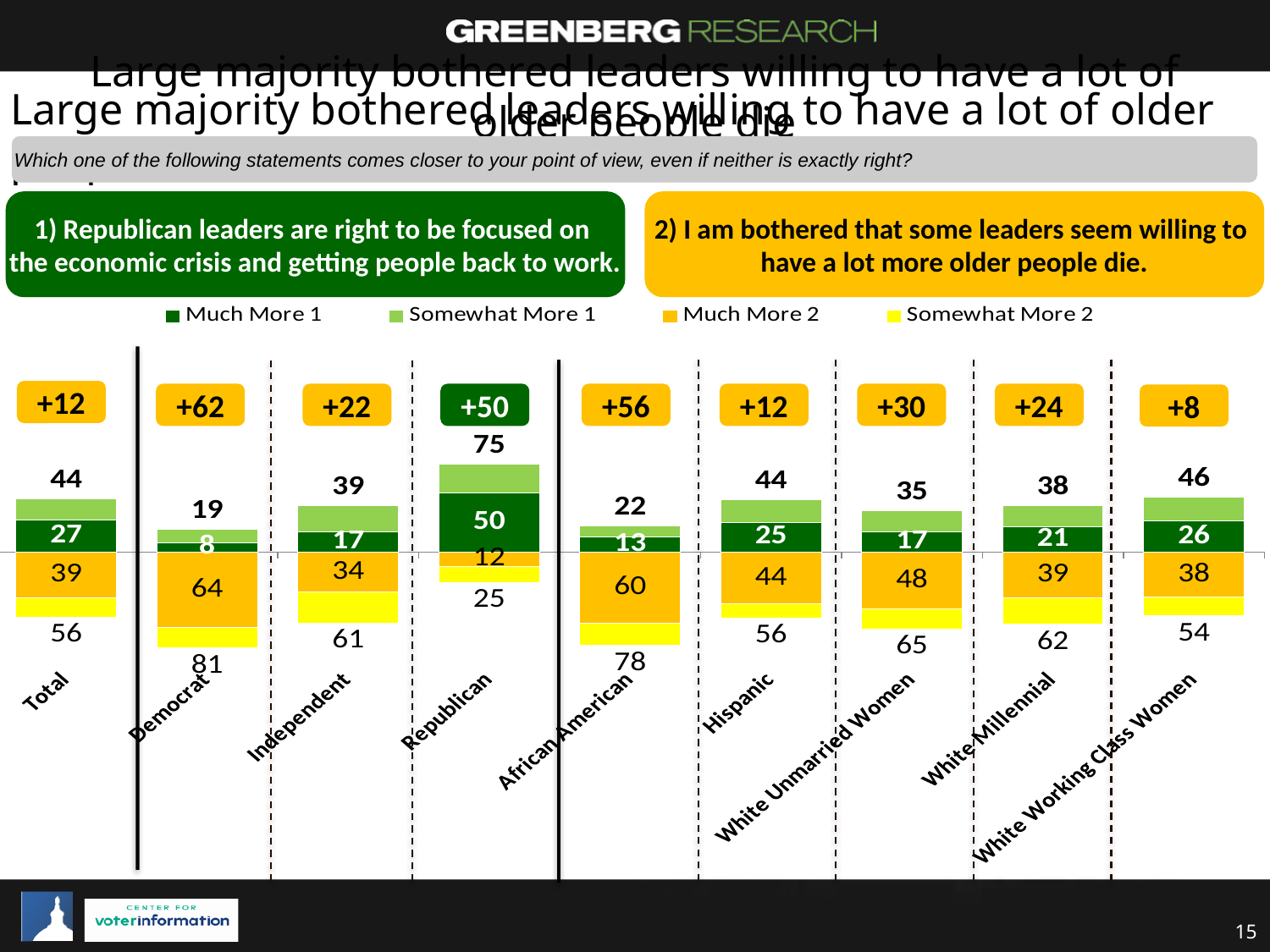
What is the Much More 1 value for Hispanic? 25 How many categories are shown on the x axis? 9 What is the net margin label shown above the African American bar? +56 What is the difference between the Much More 2 values for Democrat and Republican? 52 Which category has the highest Much More 2 value? Democrat What kind of chart is shown on the slide? Bar chart What is the Much More 1 value for Republican? 50 Which has a larger Much More 1 value, Independent or White Millennial? White Millennial Which category has the highest Much More 1 value? Republican Which category has the lowest net margin label? White Working Class Women What is the Much More 2 value for Democrat? 64 How many series does the legend list? 4